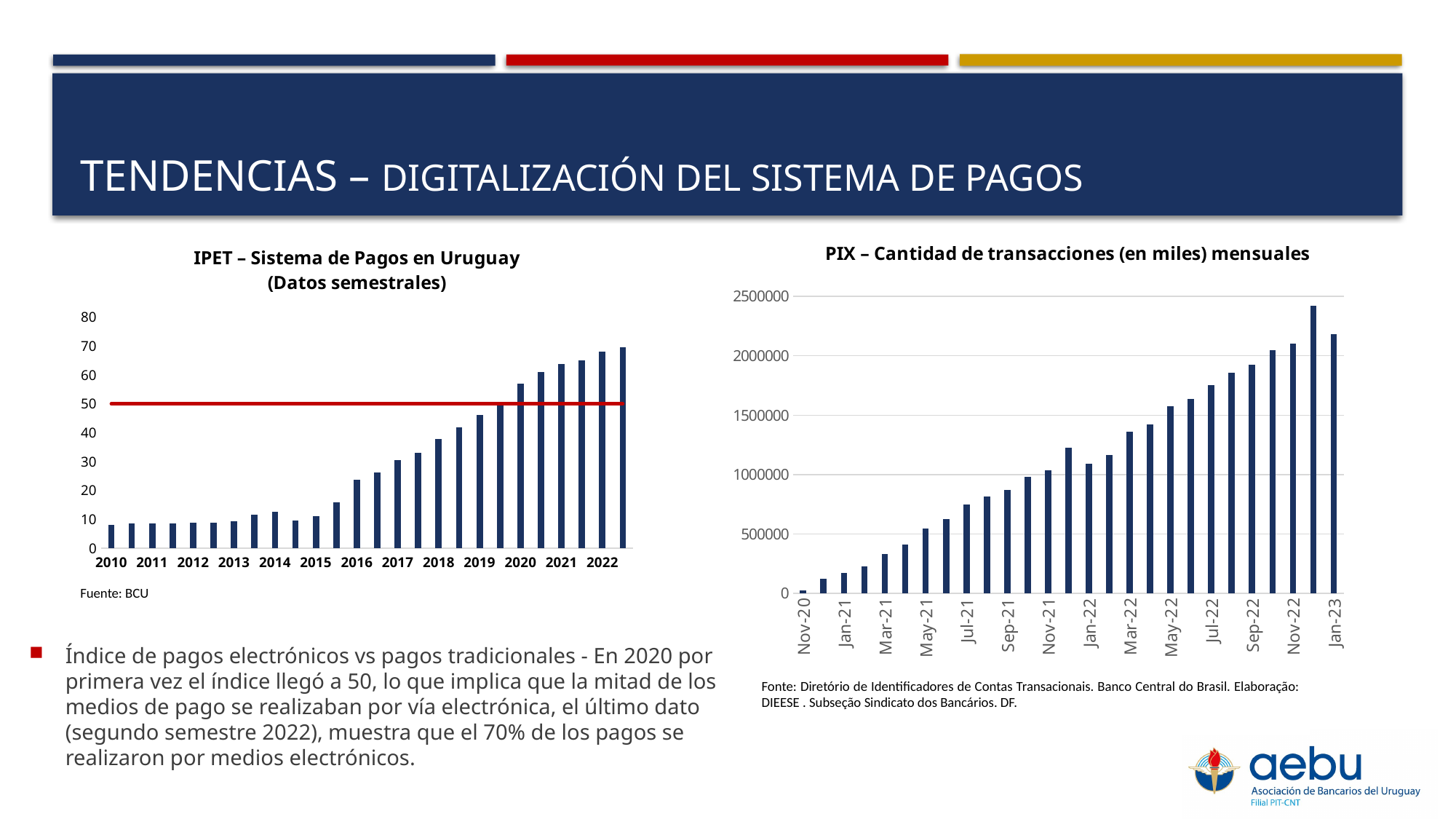
In the 'IPET – Sistema de Pagos en Uruguay' chart, at what value is the horizontal red line drawn? 50 In the 'IPET – Sistema de Pagos en Uruguay' chart, is the value of the first bar for 2010 greater or less than 10? less In the 'PIX – Cantidad de transacciones (en miles) mensuales' chart, which is larger, the value for Nov-22 or the value for Jan-23? Jan-23 What type of chart is the 'IPET – Sistema de Pagos en Uruguay' chart? combination bar and line chart In the 'PIX – Cantidad de transacciones (en miles) mensuales' chart, which month has the lowest bar? Nov-20 In the 'IPET – Sistema de Pagos en Uruguay' chart, do the values generally rise or fall from 2010 to 2022? rise In the 'IPET – Sistema de Pagos en Uruguay' chart, how many years are labeled on the x axis? 13 In the 'IPET – Sistema de Pagos en Uruguay' chart, which year has the highest bar? 2022 In the 'IPET – Sistema de Pagos en Uruguay' chart, is the value of the last bar for 2022 greater or less than 60? greater In the 'PIX – Cantidad de transacciones (en miles) mensuales' chart, is the value for Jan-23 greater or less than 2000000? greater In the 'PIX – Cantidad de transacciones (en miles) mensuales' chart, which month has the highest bar? Dec-22 In the 'PIX – Cantidad de transacciones (en miles) mensuales' chart, how many month labels are shown on the x axis? 14